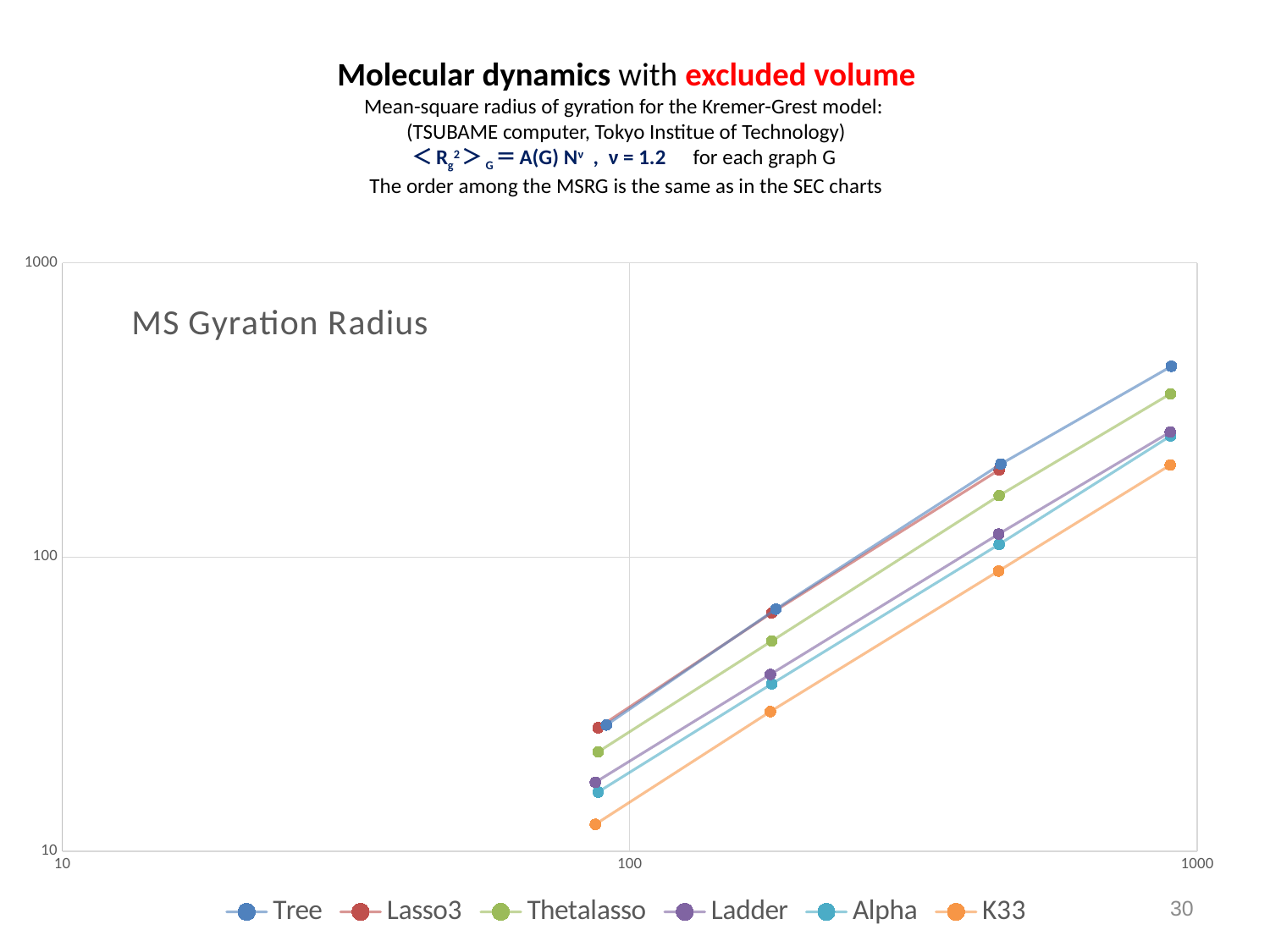
Is the value for K33 at the largest N greater or less than 100? greater Do the values for the Tree series rise or fall as N increases along the x axis? rise How many data points are plotted for the K33 series? 4 Is the value for K33 at the smallest N greater or less than 100? less What is the title shown inside the chart area? MS Gyration Radius How many series does the legend list? 6 At the largest N, which is larger: the value for Thetalasso or the value for K33? Thetalasso What kind of chart is shown on the slide? line chart Which series is plotted with the orange line? K33 Which series has the lowest values across the whole chart? K33 At the third data point, which is larger: the value for Thetalasso or the value for Ladder? Thetalasso Is the value for Thetalasso at the largest N greater or less than 1000? less